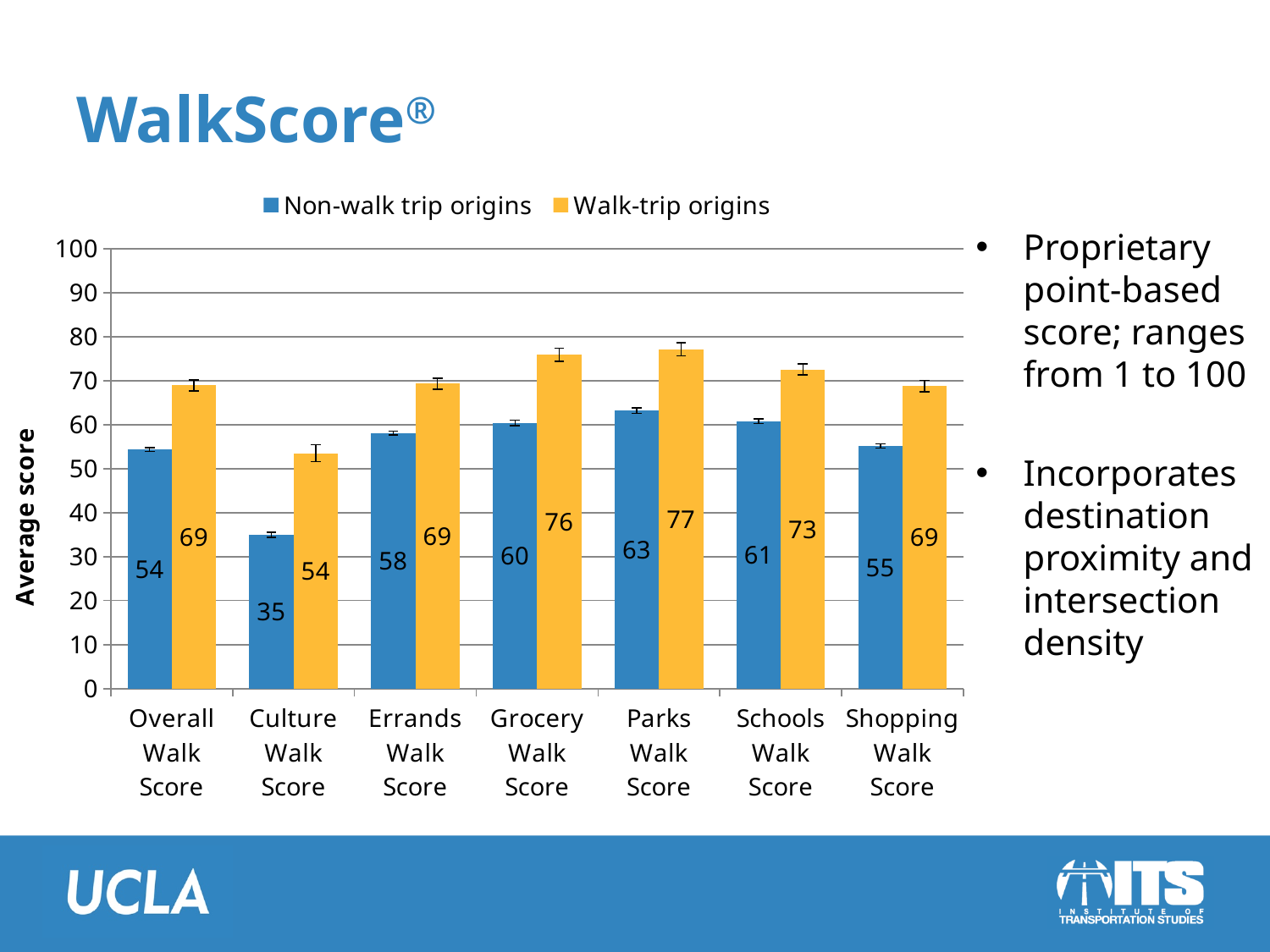
What is the Walk-trip origins value for Parks Walk Score? 77 Which category has the lowest Non-walk trip origins value? Culture Walk Score What is the Walk-trip origins value for Schools Walk Score? 73 Which is larger: the Non-walk trip origins value for Parks Walk Score or for Errands Walk Score? Parks Walk Score What is the difference between the Walk-trip origins values for Grocery Walk Score and Overall Walk Score? 7 Which category has the highest Walk-trip origins value? Parks Walk Score What kind of chart is shown on the slide? Bar chart How many categories are shown on the x axis? 7 What is the Non-walk trip origins value for Culture Walk Score? 35 What is the difference between the Walk-trip origins and Non-walk trip origins values for Culture Walk Score? 19 What is the label of the y axis? Average score How many series does the legend list? 2